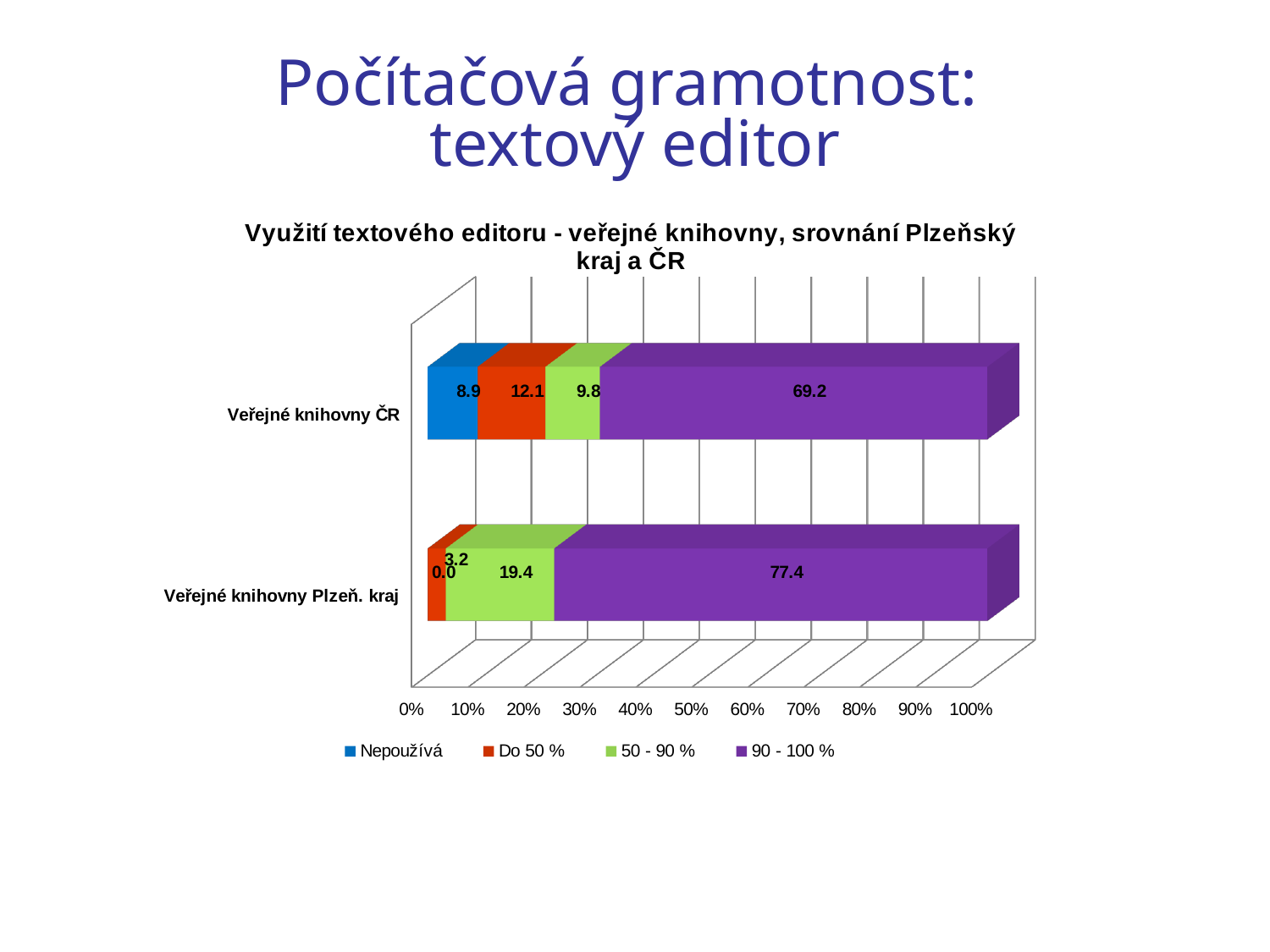
What is the value of the '90 - 100 %' series for Veřejné knihovny ČR? 69.2 What is the value of the '50 - 90 %' series for Veřejné knihovny Plzeň. kraj? 19.4 What is the value of the 'Do 50 %' series for Veřejné knihovny Plzeň. kraj? 3.2 Which category has the higher value for the '90 - 100 %' series? Veřejné knihovny Plzeň. kraj What is the difference between the '90 - 100 %' values for Veřejné knihovny Plzeň. kraj and Veřejné knihovny ČR? 8.2 What is the value of the 'Nepoužívá' series for Veřejné knihovny ČR? 8.9 What is the value of the '90 - 100 %' series for Veřejné knihovny Plzeň. kraj? 77.4 How many categories are plotted on the chart? 2 How many series does the legend list? 4 What is the title of the chart? Využití textového editoru - veřejné knihovny, srovnání Plzeňský kraj a ČR What kind of chart is shown on the slide? Stacked bar chart Which series has the lowest value for Veřejné knihovny Plzeň. kraj? Nepoužívá